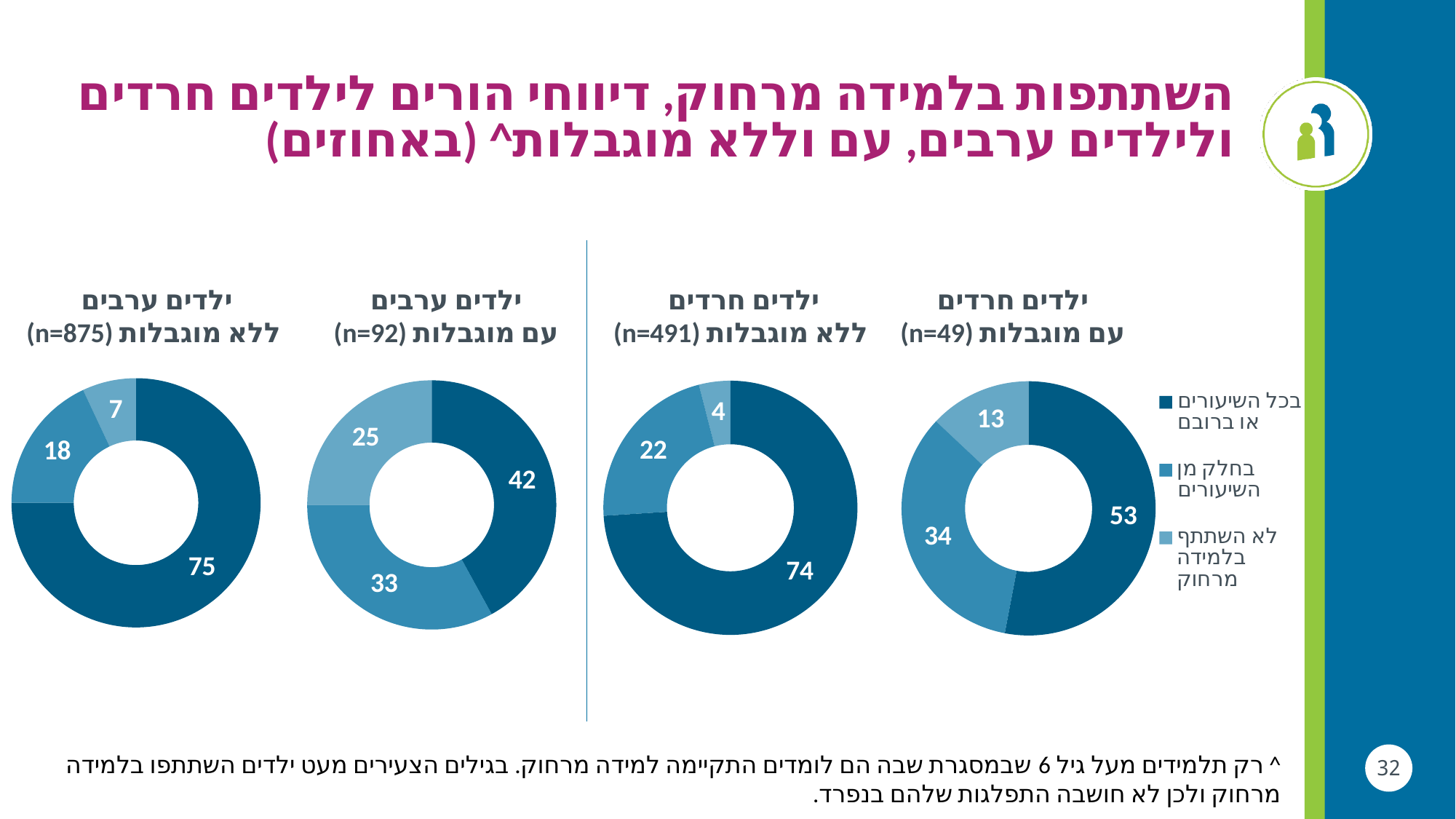
How many charts are shown on the slide? 4 In the chart titled "ילדים ערבים ללא מוגבלות (n=875)", what is the value for "בחלק מן השיעורים"? 18 In the chart titled "ילדים חרדים ללא מוגבלות (n=491)", what is the value for "לא השתתף בלמידה מרחוק"? 4 Which is larger: the "לא השתתף בלמידה מרחוק" value in the "ילדים ערבים עם מוגבלות (n=92)" chart or in the "ילדים ערבים ללא מוגבלות (n=875)" chart? ילדים ערבים עם מוגבלות (n=92) In the chart titled "ילדים ערבים ללא מוגבלות (n=875)", what is the value for "בכל השיעורים או ברובם"? 75 What is the difference between the "בכל השיעורים או ברובם" values in the "ילדים חרדים ללא מוגבלות (n=491)" chart and the "ילדים חרדים עם מוגבלות (n=49)" chart? 21 What kind of chart is the chart titled "ילדים חרדים ללא מוגבלות (n=491)"? Donut (pie) chart In the chart titled "ילדים חרדים עם מוגבלות (n=49)", what is the value for "בכל השיעורים או ברובם"? 53 In the chart titled "ילדים ערבים עם מוגבלות (n=92)", what is the value for "בחלק מן השיעורים"? 33 How many categories does the legend list? 3 In the chart titled "ילדים ערבים עם מוגבלות (n=92)", which category has the largest share? בכל השיעורים או ברובם In the chart titled "ילדים חרדים עם מוגבלות (n=49)", which category has the smallest share? לא השתתף בלמידה מרחוק